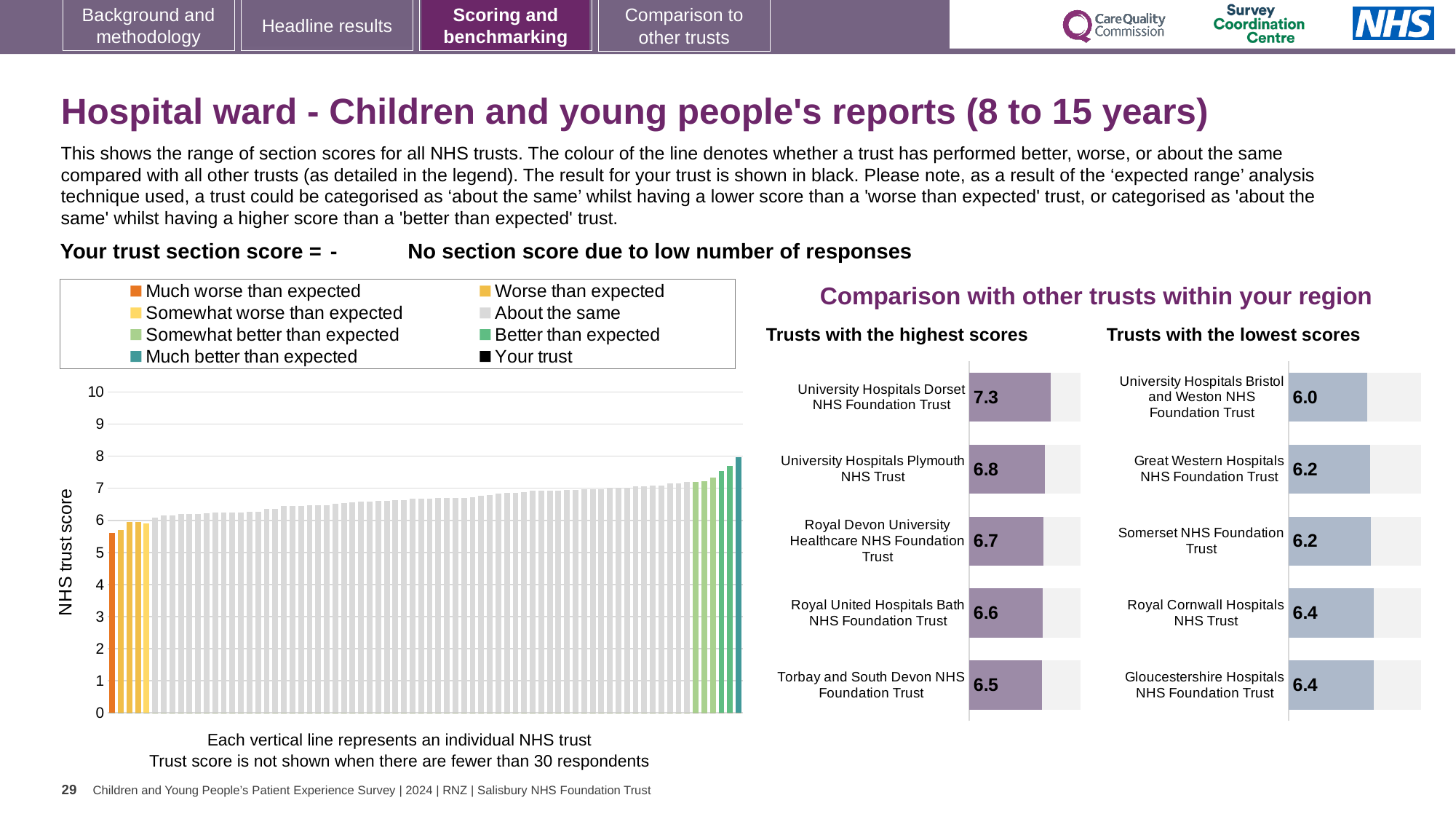
In the 'Trusts with the lowest scores' chart, which has the larger score: Somerset NHS Foundation Trust or Royal Cornwall Hospitals NHS Trust? Royal Cornwall Hospitals NHS Trust How many trusts are listed in the 'Trusts with the highest scores' chart? 5 How many entries does the legend above the main 'NHS trust score' chart list? 8 In the 'Trusts with the highest scores' chart, what is the difference between the scores of University Hospitals Dorset NHS Foundation Trust and Torbay and South Devon NHS Foundation Trust? 0.8 In the 'Trusts with the lowest scores' chart, what is the difference between the scores of Royal Cornwall Hospitals NHS Trust and University Hospitals Bristol and Weston NHS Foundation Trust? 0.4 In the 'Trusts with the highest scores' chart, which trust has the highest score? University Hospitals Dorset NHS Foundation Trust In the 'Trusts with the highest scores' chart, what is the score for University Hospitals Dorset NHS Foundation Trust? 7.3 In the 'Trusts with the highest scores' chart, what is the score for Royal United Hospitals Bath NHS Foundation Trust? 6.6 In the 'Trusts with the lowest scores' chart, what is the score for Great Western Hospitals NHS Foundation Trust? 6.2 In the main 'NHS trust score' chart on the left, is the value of the leftmost (orange) bar greater or less than 6? less In the main 'NHS trust score' chart on the left, do the bar values rise or fall from left to right? rise In the 'Trusts with the lowest scores' chart, which trust has the lowest score? University Hospitals Bristol and Weston NHS Foundation Trust